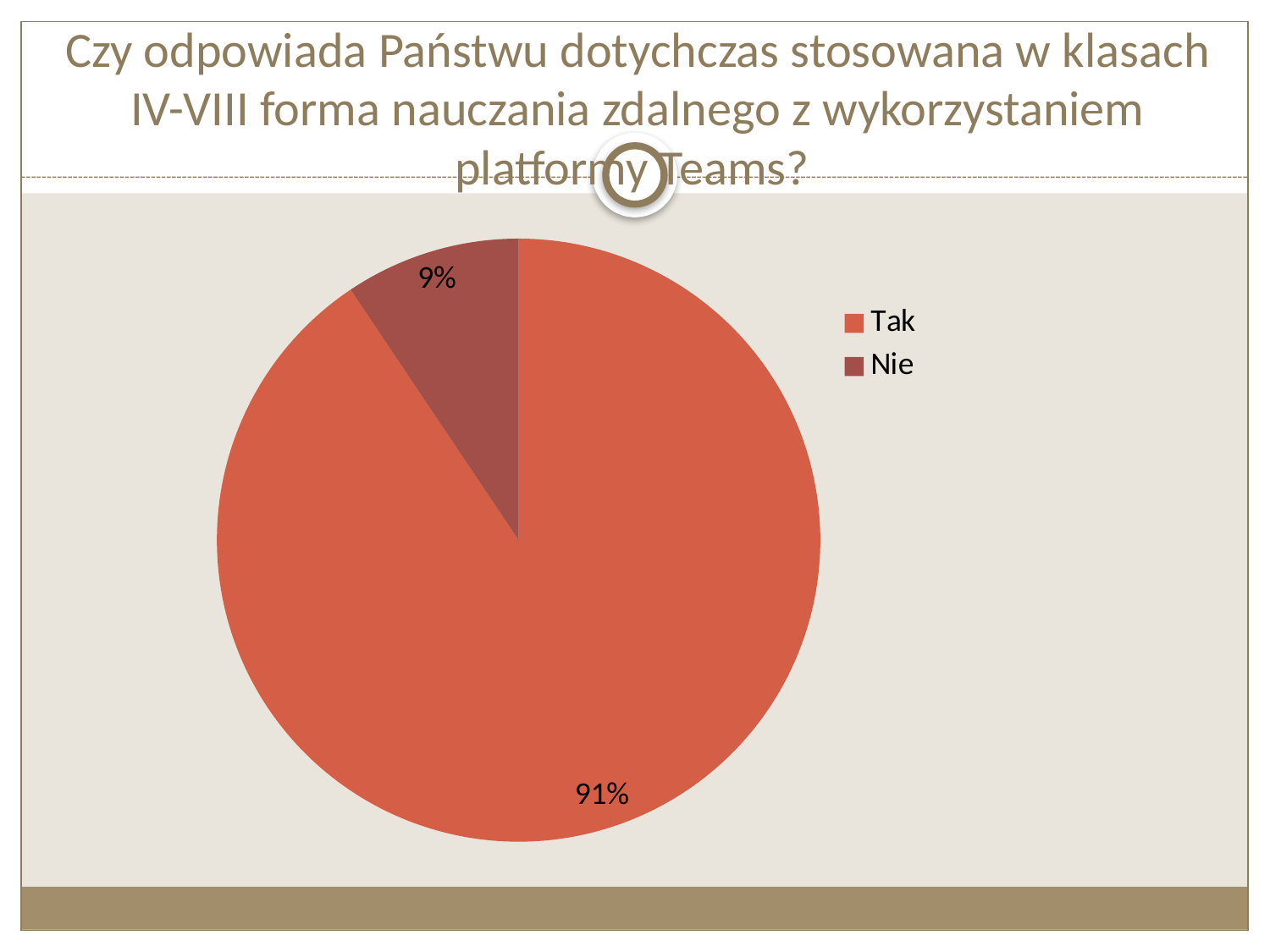
How many slices does the pie chart have? 2 Which slice of the pie is the smallest? Nie How many entries does the legend list? 2 Where is the legend positioned relative to the pie? to the right What kind of chart is shown on the slide? pie chart What percentage of the pie is labelled for "Nie"? 9% What percentage of the pie is labelled for "Tak"? 91% What is the difference in percentage points between the "Tak" and "Nie" slices? 82 Which slice is larger, "Tak" or "Nie"? Tak What share of the pie does the "Nie" slice represent? 9% What colour is the "Tak" slice in the pie chart? red-orange Which slice of the pie is the largest? Tak